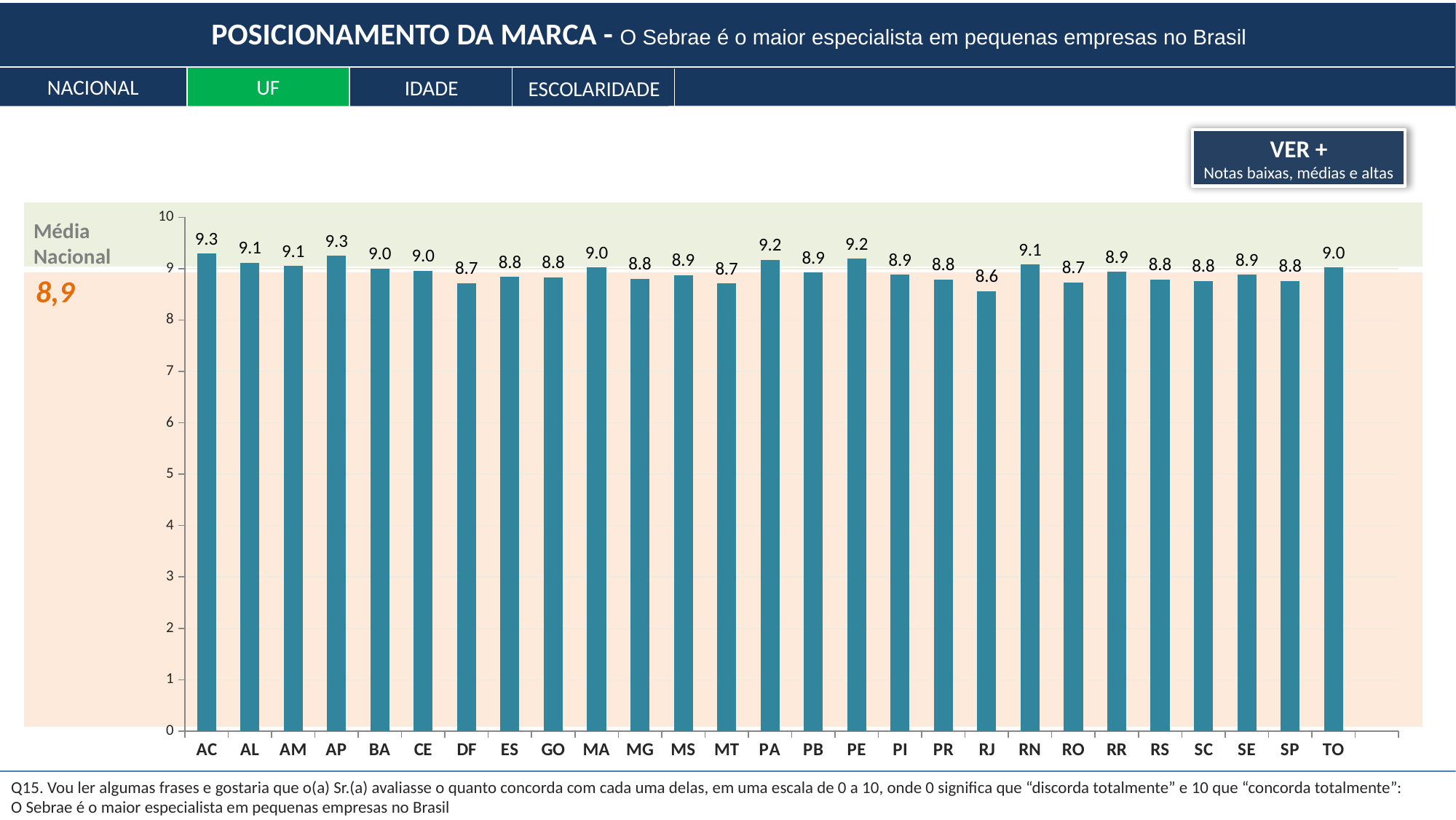
What is the value for RJ? 8.6 Which is larger, the value for RN or the value for RO? RN How many states are shown on the x axis? 27 What is the Média Nacional value shown on the chart? 8,9 What is the value for PA? 9.2 Which state has the lowest value? RJ What is the difference between the values for PE and MT? 0.5 What is the value for DF? 8.7 What is the value for TO? 9.0 What is the difference between the values for AC and RJ? 0.7 What kind of chart is shown on the slide? bar chart Is the value for SP greater or less than 8? greater